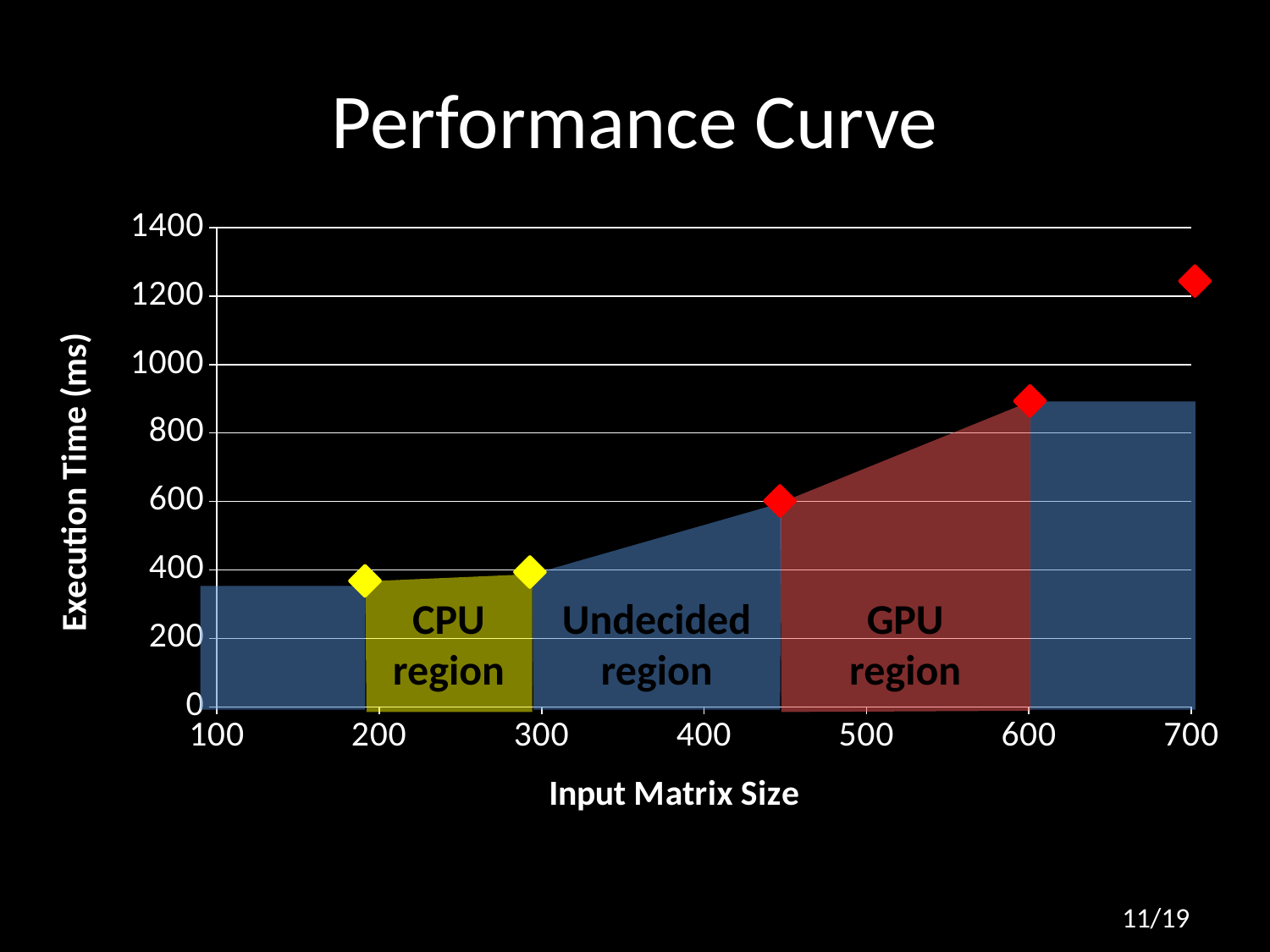
Is the execution time at input matrix size 700 larger or smaller than at 600? larger Is the execution time at input matrix size 600 greater or less than 800? greater Is the execution time at input matrix size 100 greater or less than 400? less What kind of chart is shown on the slide? area chart What is the title of the chart? Performance Curve Do the execution time values rise or fall as the input matrix size increases along the x axis? rise What is the label of the y axis? Execution Time (ms) Is the execution time at input matrix size 200 greater or less than 400? less Which input matrix size has the highest execution time? 700 How many diamond markers are plotted on the chart? 5